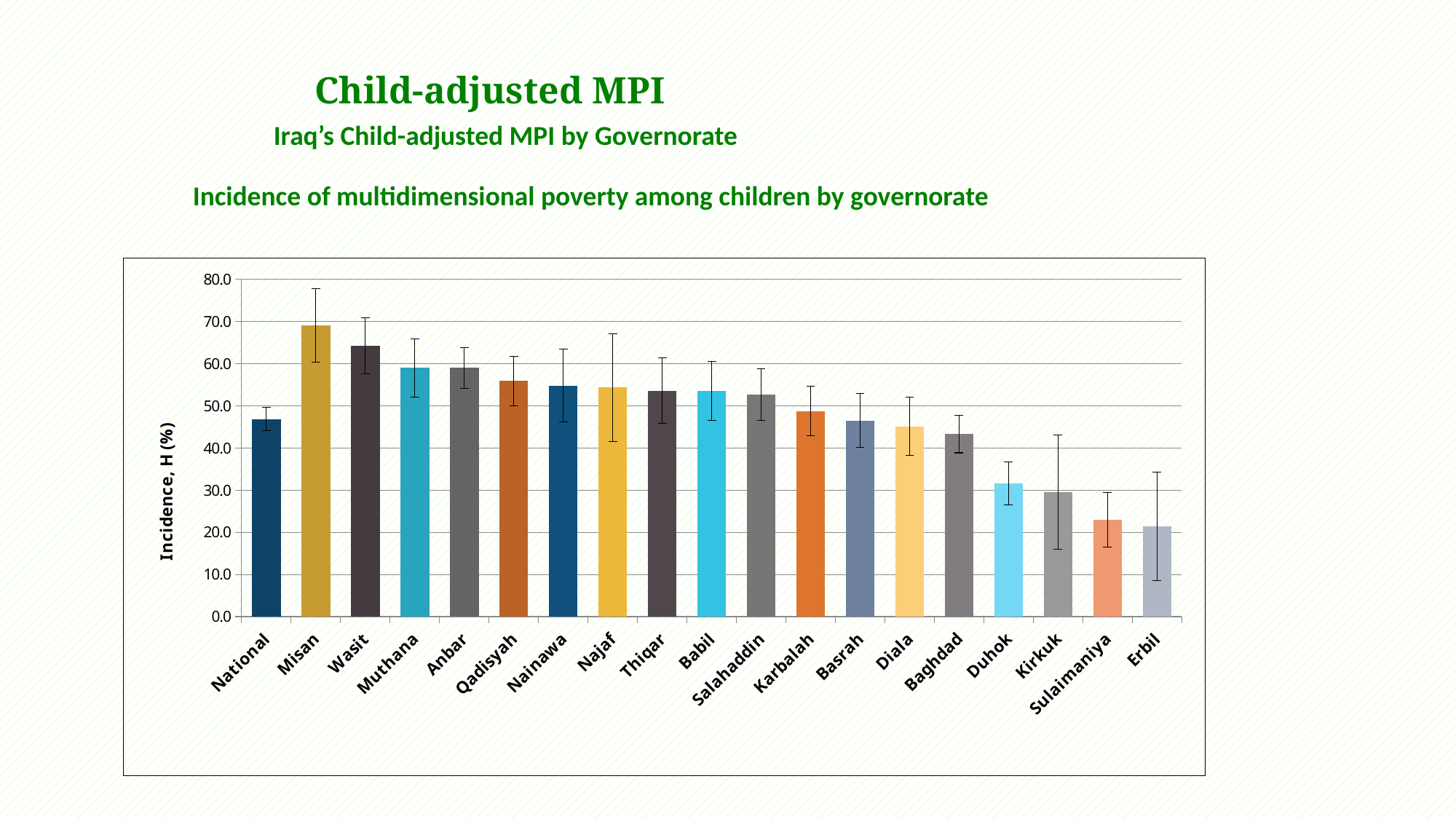
What kind of chart is shown on the slide? bar chart Which category has the highest incidence of multidimensional poverty among children? Misan Do the governorate values generally rise or fall from left to right along the x axis? fall Is the value for National greater or less than 50? less Which has a higher incidence, Wasit or Muthana? Wasit What is the label on the vertical axis of the chart? Incidence, H (%) Is the value for Sulaimaniya greater or less than 30? less Is the value for Misan greater or less than 60? greater How many bars (categories) are plotted in the chart? 19 Which has a higher incidence, Baghdad or Duhok? Baghdad